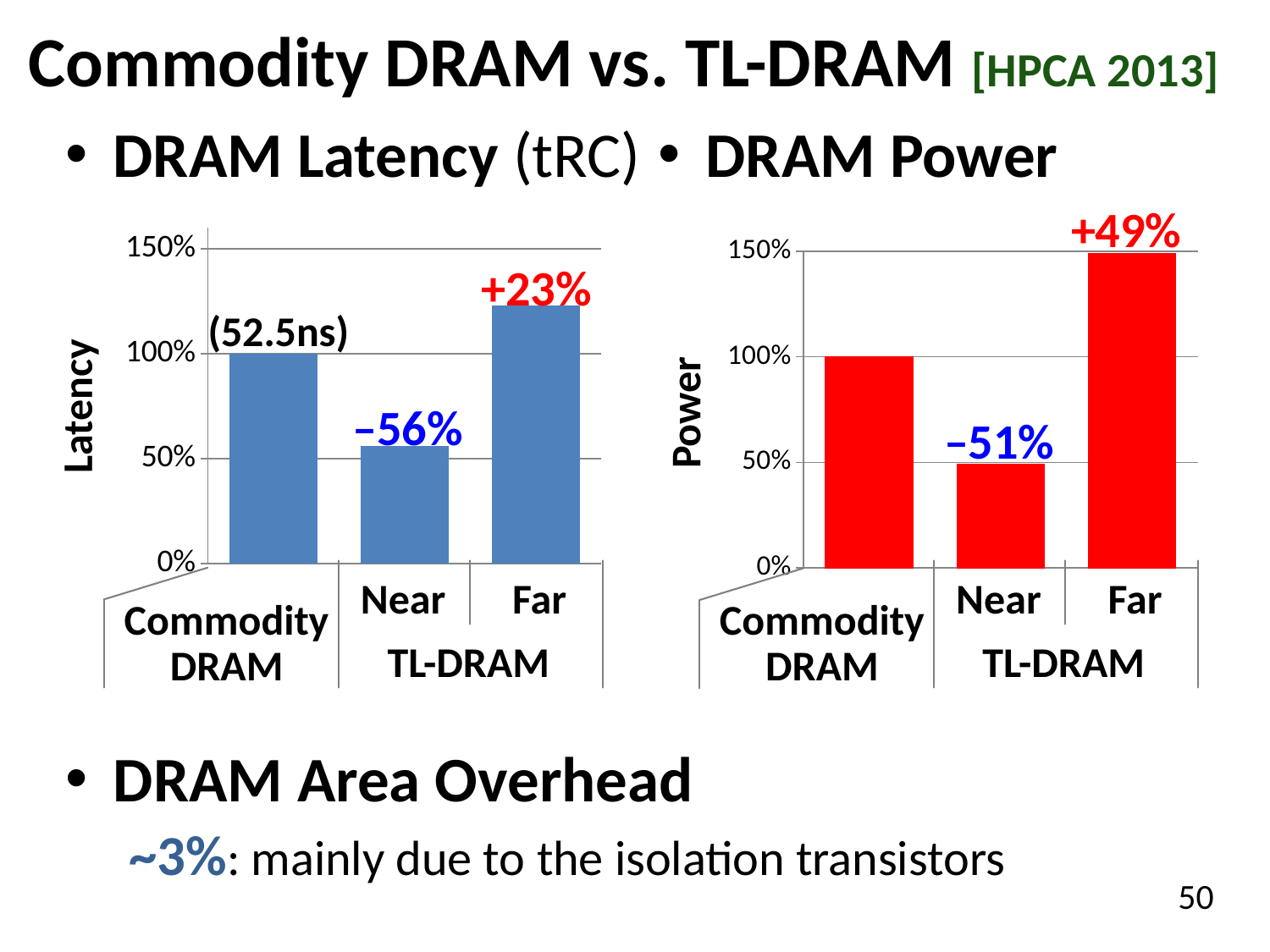
In the DRAM Latency chart, which bar is the lowest? Near (TL-DRAM) In the DRAM Power chart, which bar is the highest? Far (TL-DRAM) In the DRAM Latency chart, what value does the Commodity DRAM bar reach on the axis? 100% In the DRAM Latency chart, what change label is printed above the TL-DRAM Near bar? –56% In the DRAM Latency chart, what absolute latency is noted in parentheses above the Commodity DRAM bar? (52.5ns) In the DRAM Power chart, what change label is printed above the TL-DRAM Far bar? +49% In the DRAM Power chart, is the value for the TL-DRAM Near bar greater or less than 100%? less In the DRAM Latency chart, what change label is printed above the TL-DRAM Far bar? +23% In the DRAM Power chart, what change label is printed above the TL-DRAM Near bar? –51% In the DRAM Latency chart, how many bars are plotted? 3 What kind of chart is the DRAM Latency chart on the left? bar chart In the DRAM Latency chart, is the value for the TL-DRAM Far bar greater or less than 100%? greater